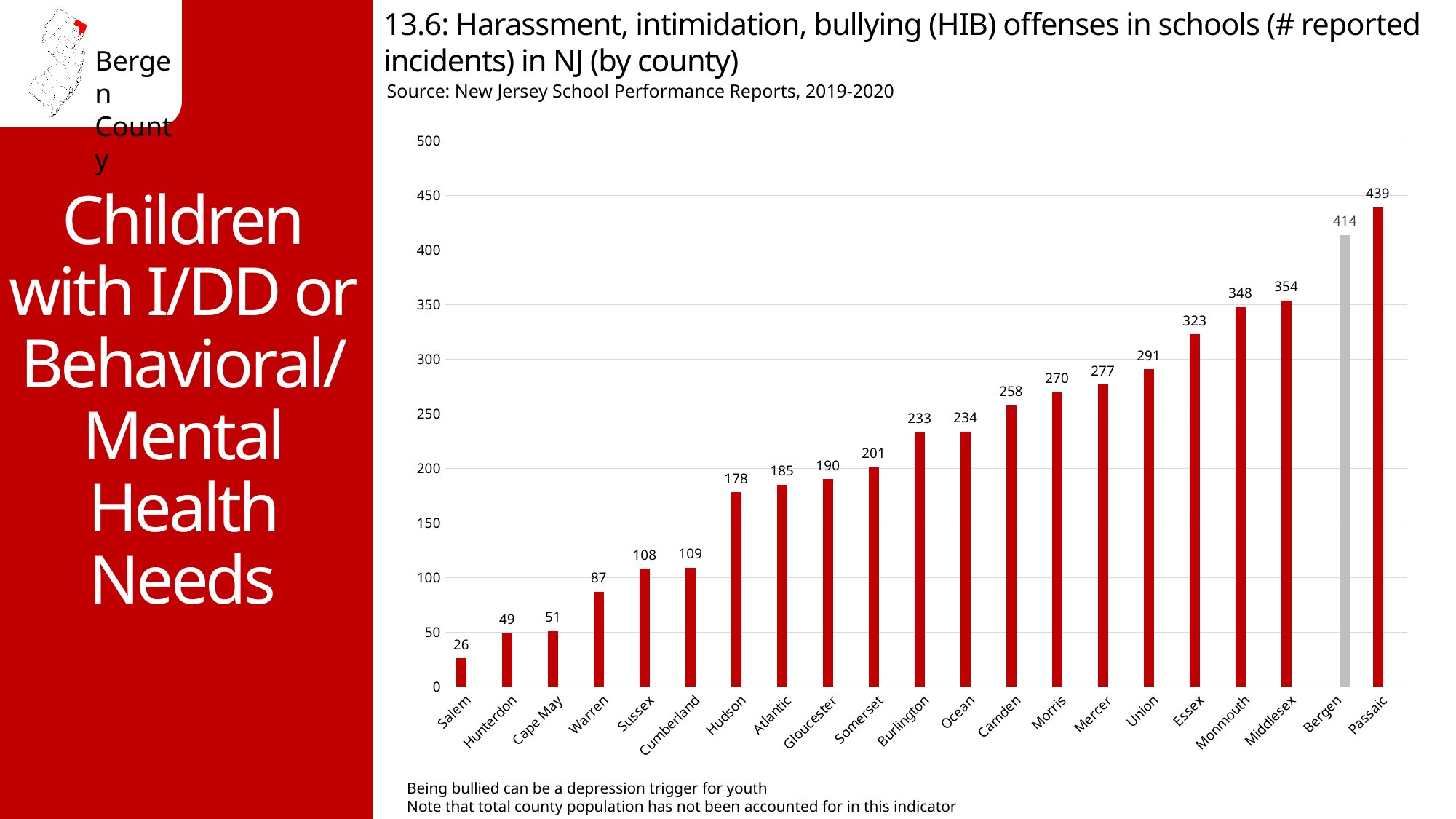
What is the difference in reported HIB incidents between Passaic and Bergen? 25 Do the values rise or fall moving from left to right along the x axis? Rise Which county's bar is shown in grey rather than red? Bergen Which county has the highest number of reported HIB incidents? Passaic Is the value for Union greater or less than 300? less What is the difference in reported HIB incidents between Cumberland and Sussex? 1 How many counties are shown on the chart? 21 What is the number of reported HIB incidents for Hudson? 178 How many HIB incidents were reported for Bergen County? 414 What kind of chart is shown on the slide? Bar chart Which county has more reported HIB incidents, Essex or Monmouth? Monmouth Which county has the lowest number of reported HIB incidents? Salem